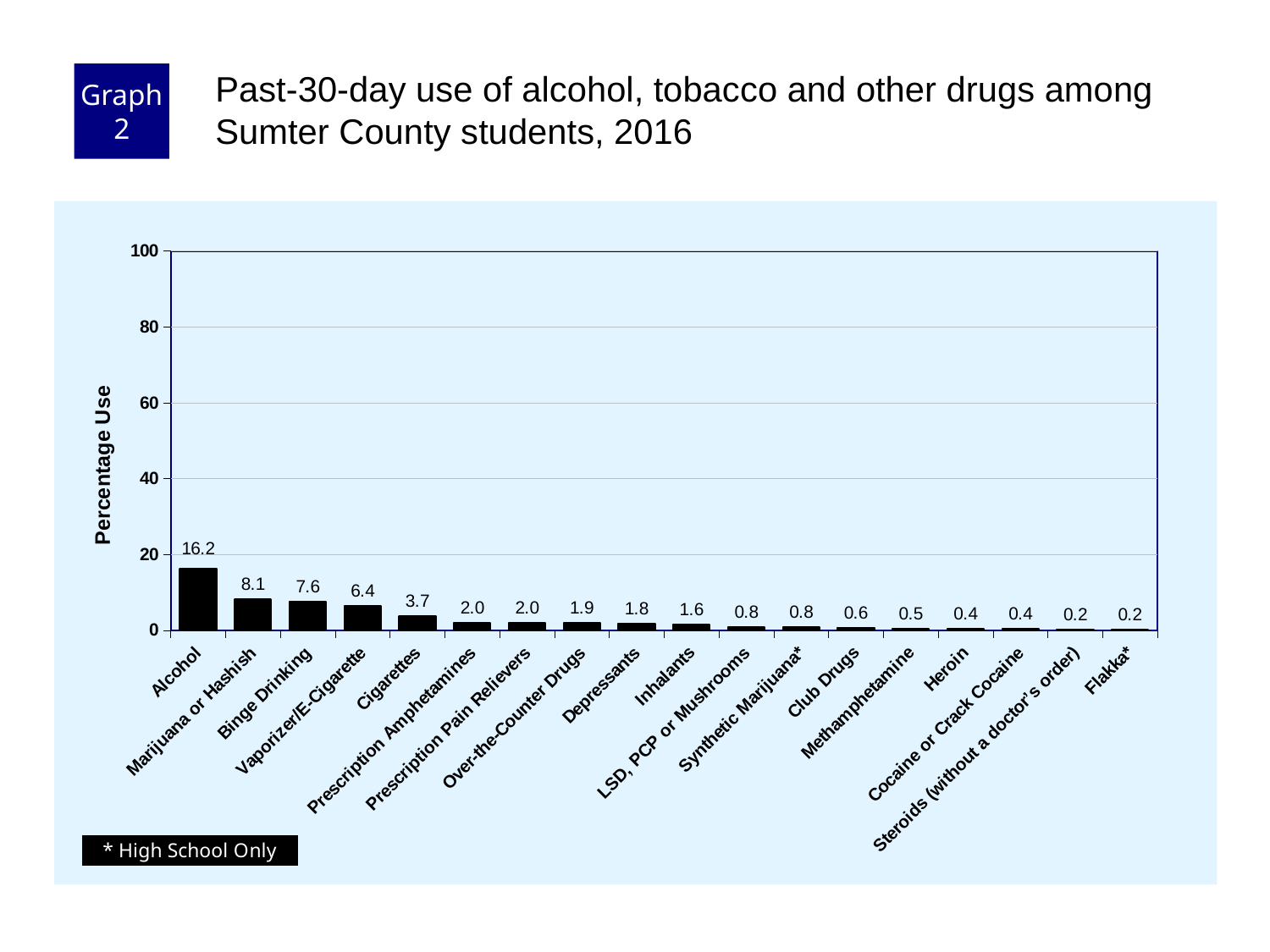
What is the percentage use for Inhalants? 1.6 What kind of chart is shown on the slide? Bar chart Which has a higher percentage use, Binge Drinking or Vaporizer/E-Cigarette? Binge Drinking What is the percentage use for Cigarettes? 3.7 What is the percentage use for Alcohol? 16.2 What is the percentage use for Binge Drinking? 7.6 What is the label of the y axis? Percentage Use How many categories are shown on the x axis? 18 Is the value for Alcohol greater or less than 20? less Which category has the highest percentage use? Alcohol What is the difference in percentage use between Vaporizer/E-Cigarette and Cigarettes? 2.7 What is the difference in percentage use between Alcohol and Marijuana or Hashish? 8.1